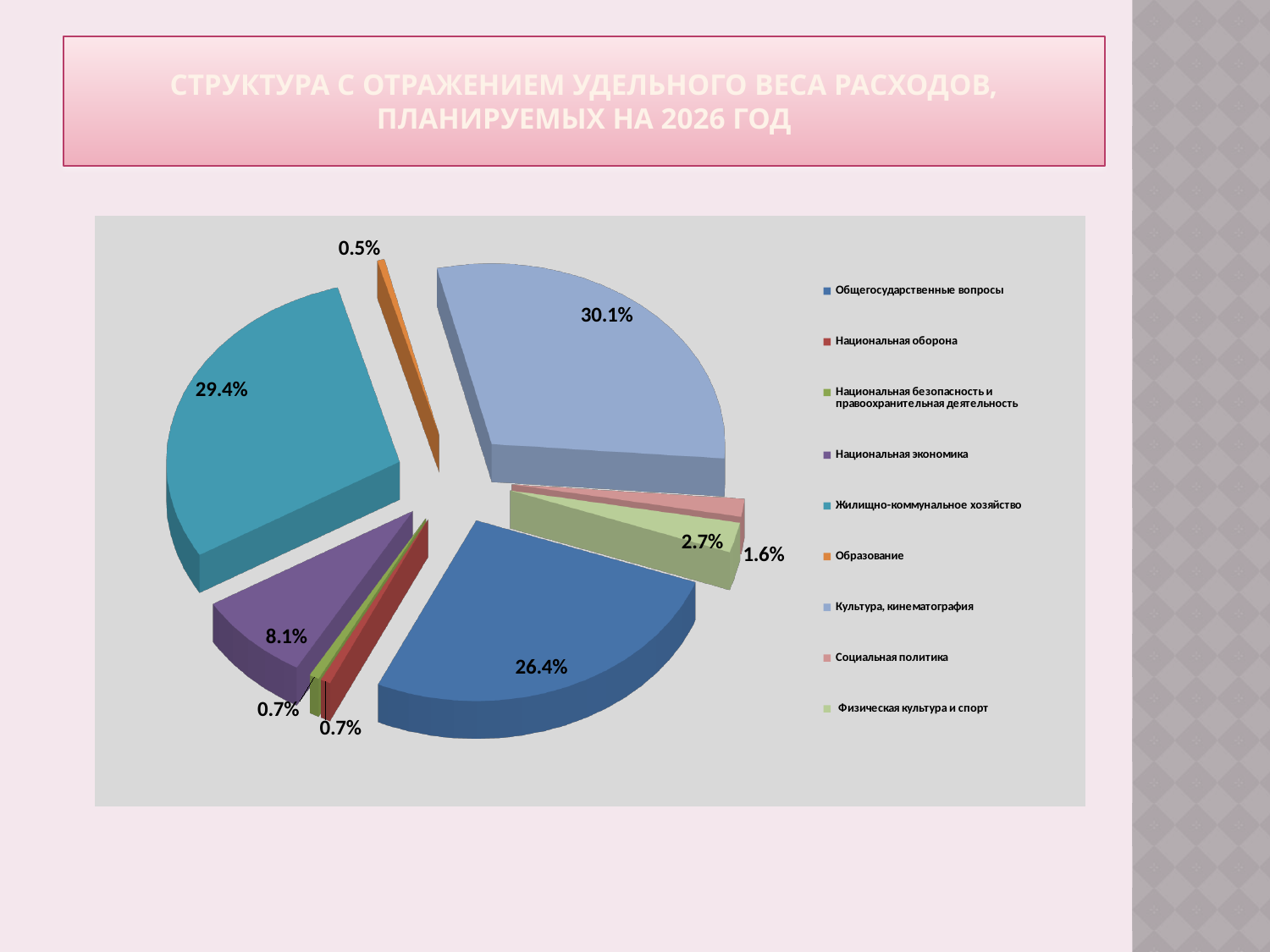
What is the title of the slide? Структура с отражением удельного веса расходов, планируемых на 2026 год How many categories does the legend of the pie chart list? 9 Which category has the largest share of the pie? Культура, кинематография Which category has the smallest share of the pie? Образование What share does Национальная экономика have? 8.1% What is the difference in percentage points between the shares of Культура, кинематография and Общегосударственные вопросы? 3.7 What type of chart is shown on the slide? Pie chart What share does Образование have? 0.5% What share does Жилищно-коммунальное хозяйство have? 29.4% What share does Общегосударственные вопросы have? 26.4% Which has the larger share: Общегосударственные вопросы or Национальная экономика? Общегосударственные вопросы What colour is the slice for Жилищно-коммунальное хозяйство? Teal